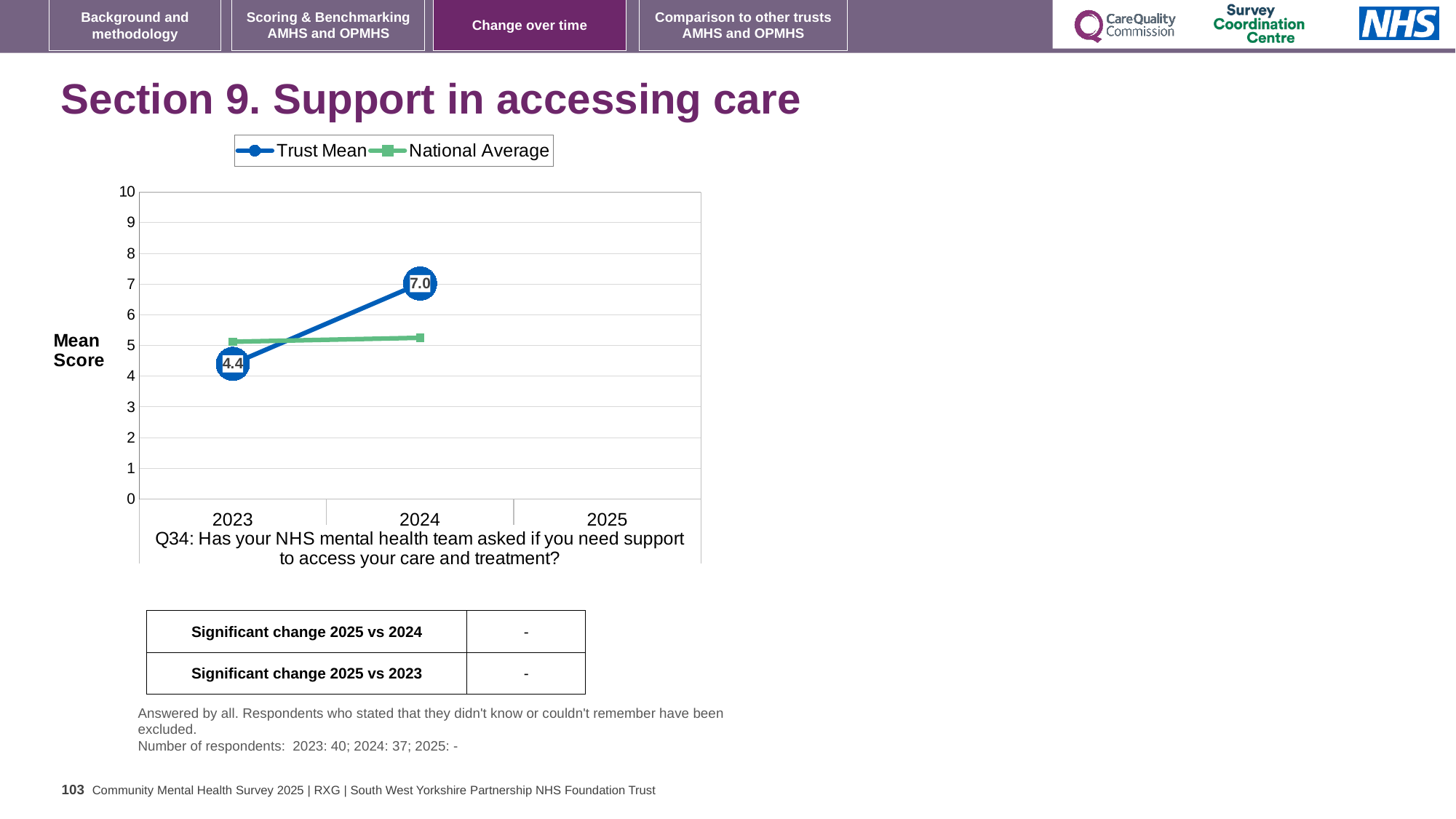
Is the National Average value for 2024 greater or less than 6? less What is the Trust Mean score for 2024? 7.0 How many years are shown on the x axis? 3 What is the label on the y axis of the chart? Mean Score What kind of chart is shown on the slide? line chart By how much did the Trust Mean score change from 2023 to 2024? 2.6 How many series does the legend list? 2 In 2023, which series is higher, Trust Mean or National Average? National Average In 2024, which series is higher, Trust Mean or National Average? Trust Mean What is the Trust Mean score for 2023? 4.4 Does the Trust Mean rise or fall from 2023 to 2024? rise Which year has the higher Trust Mean score, 2023 or 2024? 2024